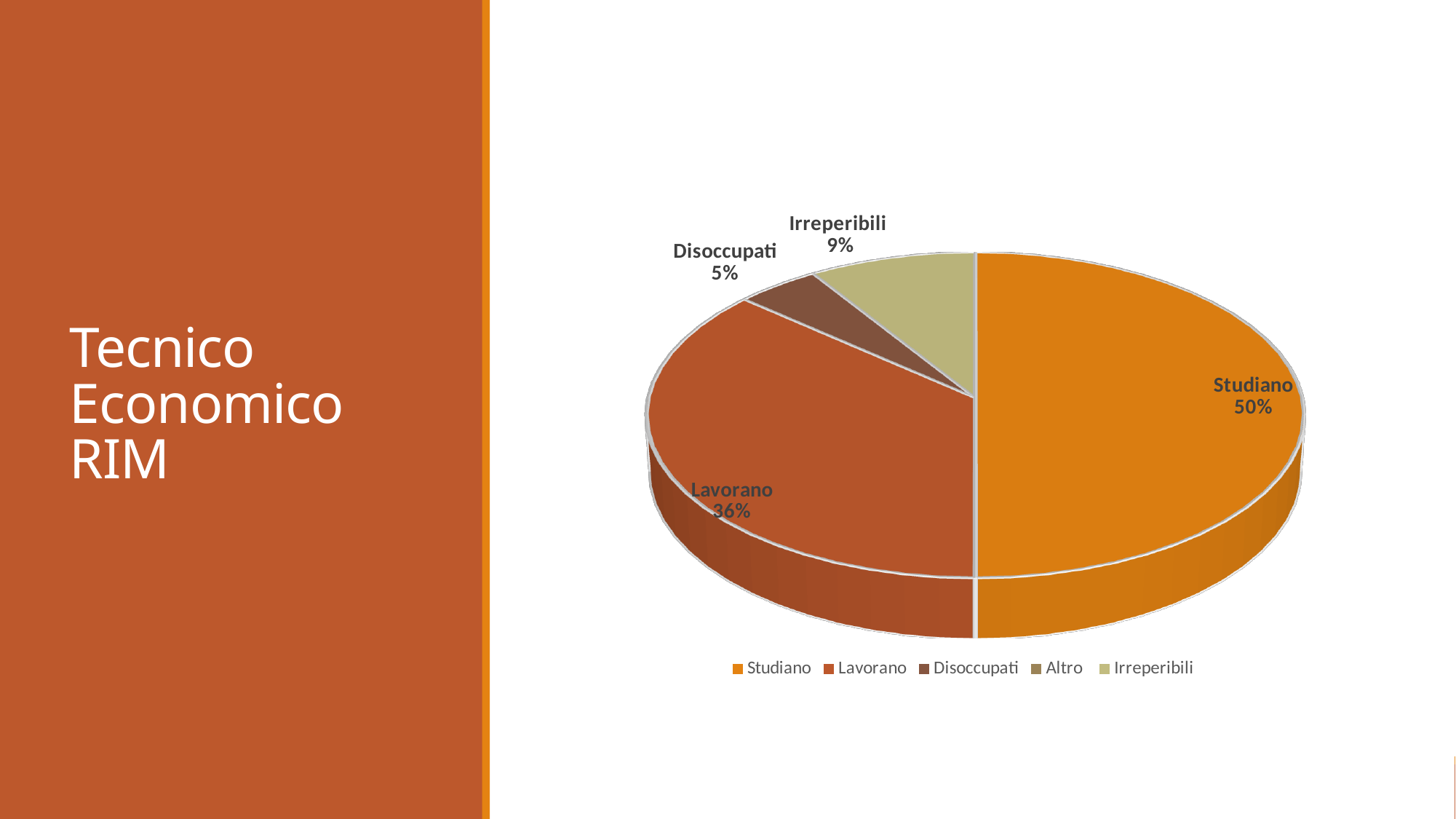
Which category has the largest slice of the pie? Studiano What is the combined share of Disoccupati and Irreperibili? 14% What percentage of the pie is labelled Studiano? 50% What is the difference in percentage points between Studiano and Lavorano? 14 What percentage of the pie is labelled Lavorano? 36% How many entries does the legend list? 5 Which is larger, the Irreperibili slice or the Disoccupati slice? Irreperibili Which legend entry has no visible slice in the pie? Altro Which of the labelled slices is the smallest? Disoccupati What percentage of the pie is labelled Irreperibili? 9% What kind of chart is shown on the slide? Pie chart What percentage of the pie is labelled Disoccupati? 5%